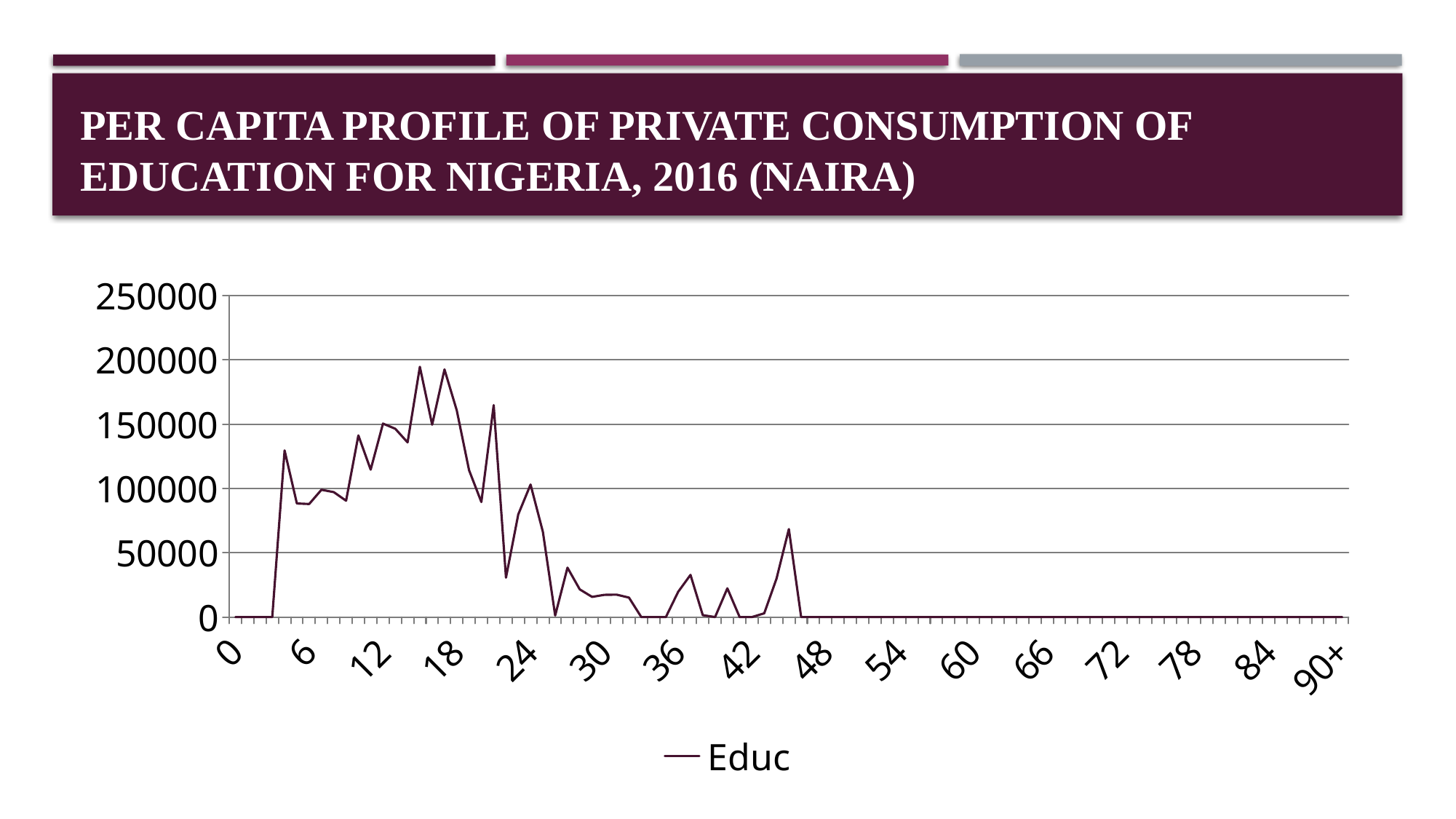
How many series does the legend list? 1 Is the value for age 18 greater or less than 150000? greater Is the value for age 30 greater or less than 50000? less What is the value for age 60? 0 What kind of chart is shown on the slide? line chart Do the values generally rise or fall between age 18 and age 30? fall What is the name of the series shown in the legend? Educ Is the value for age 6 greater or less than 100000? less Which is larger, the value at age 12 or the value at age 36? age 12 What is the value for age 0? 0 What is the highest value shown on the vertical axis? 250000